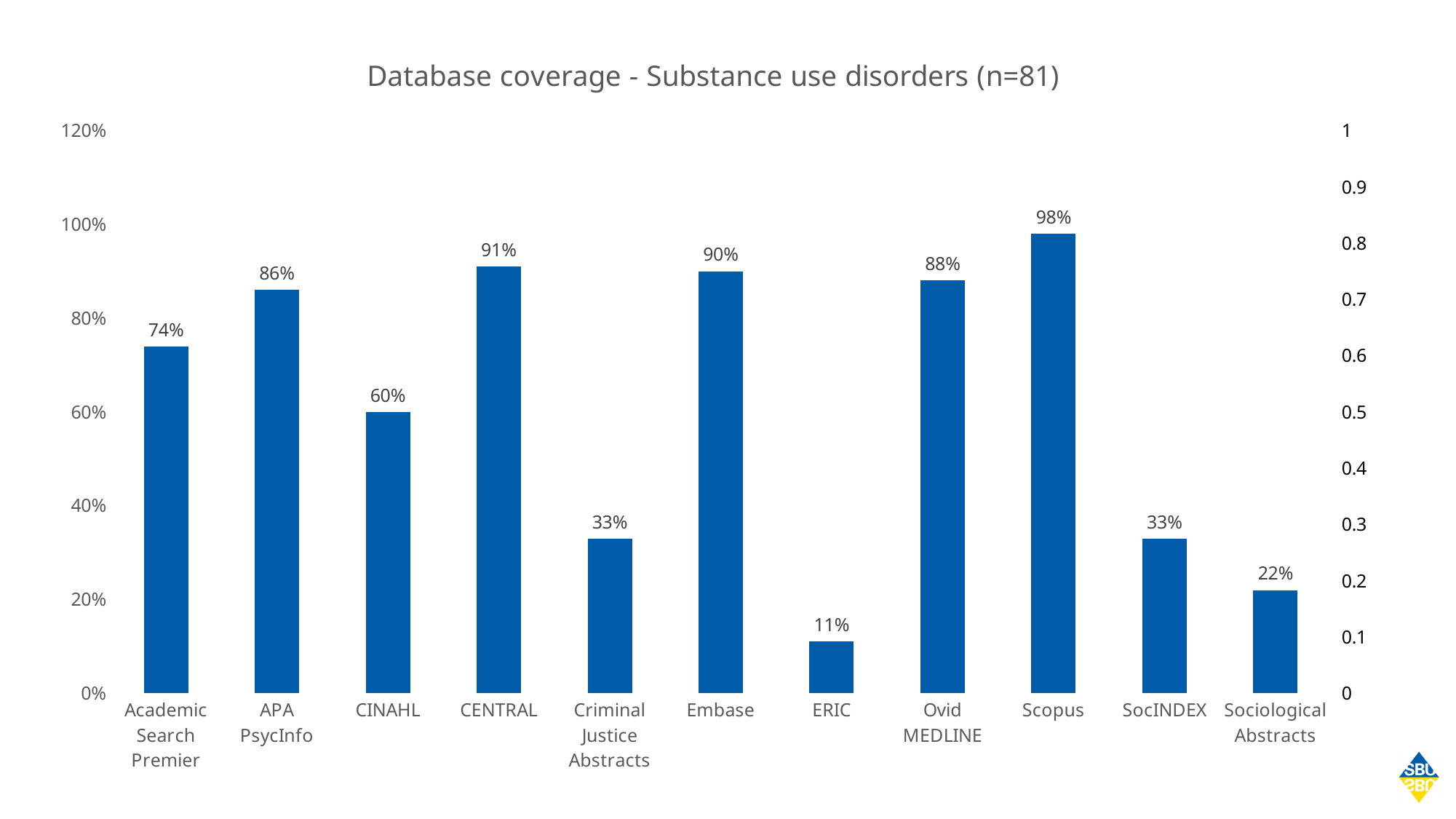
What is the title of the chart? Database coverage - Substance use disorders (n=81) Which has higher coverage, APA PsycInfo or CINAHL? APA PsycInfo What is the difference between the coverage of Academic Search Premier and Sociological Abstracts? 52% What is the database coverage value for Ovid MEDLINE? 88% How many databases are shown on the chart? 11 Which database has the highest coverage? Scopus What kind of chart is shown on the slide? Bar chart Which database has the lowest coverage? ERIC What is the difference between the coverage of CENTRAL and Embase? 1% What is the database coverage value for CINAHL? 60% Is the value for Criminal Justice Abstracts greater or less than 40%? less What is the database coverage value for Scopus? 98%